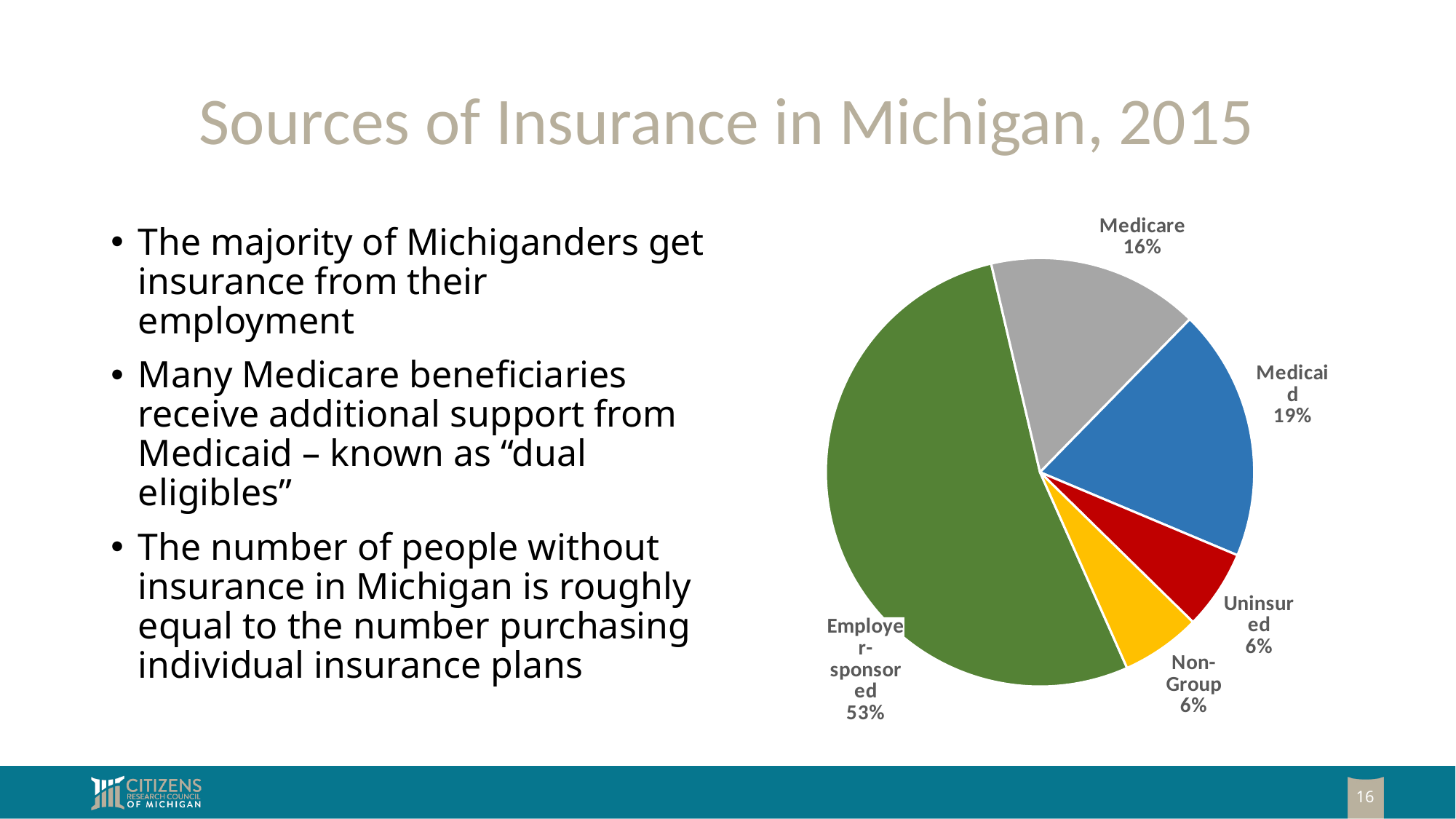
Which is larger, the Medicaid slice or the Medicare slice? Medicaid What percentage of the pie is Uninsured? 6% Which source of insurance has the largest slice of the pie? Employer-sponsored What percentage is shown for Medicaid? 19% What share of the pie does Employer-sponsored insurance account for? 53% What colour is the Employer-sponsored slice? Green How many slices does the pie chart have? 5 What is the title of the slide containing the chart? Sources of Insurance in Michigan, 2015 What is the combined percentage of Non-Group and Uninsured? 12% What is the difference in percentage points between Medicaid and Medicare? 3 What percentage is shown for Medicare? 16% What kind of chart is shown on the slide? Pie chart